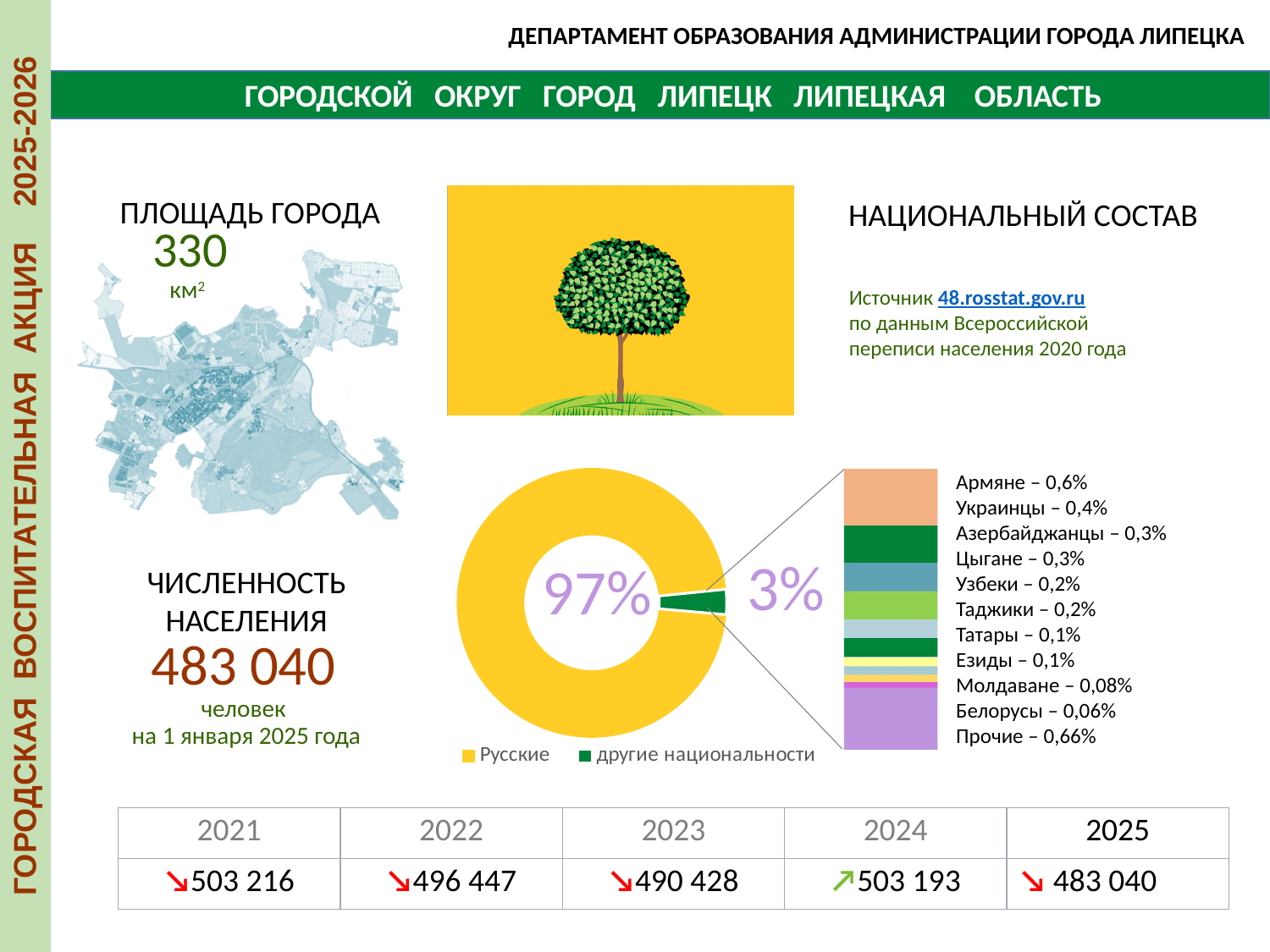
How many entries does the legend of the national composition pie chart list? 2 In the breakdown of the 3% slice, what is the value for Татары? 0,1% In the breakdown of the 3% slice, what is the value for Армяне? 0,6% What colour represents Русские in the national composition pie chart? yellow In the national composition pie chart, what share is labelled for Русские? 97% In the national composition pie chart, what share is labelled for другие национальности? 3% In the national composition pie chart, which slice is the largest? Русские What kind of chart shows the national composition (Русские vs другие национальности)? pie chart (donut) In the breakdown of the 3% slice, which is larger: Украинцы or Молдаване? Украинцы In the national composition pie chart, which slice is the smallest? другие национальности In the national composition pie chart, what is the difference in percentage points between the Русские slice and the другие национальности slice? 94 In the breakdown of the 3% slice, which named nationality (excluding Прочие) has the highest share? Армяне